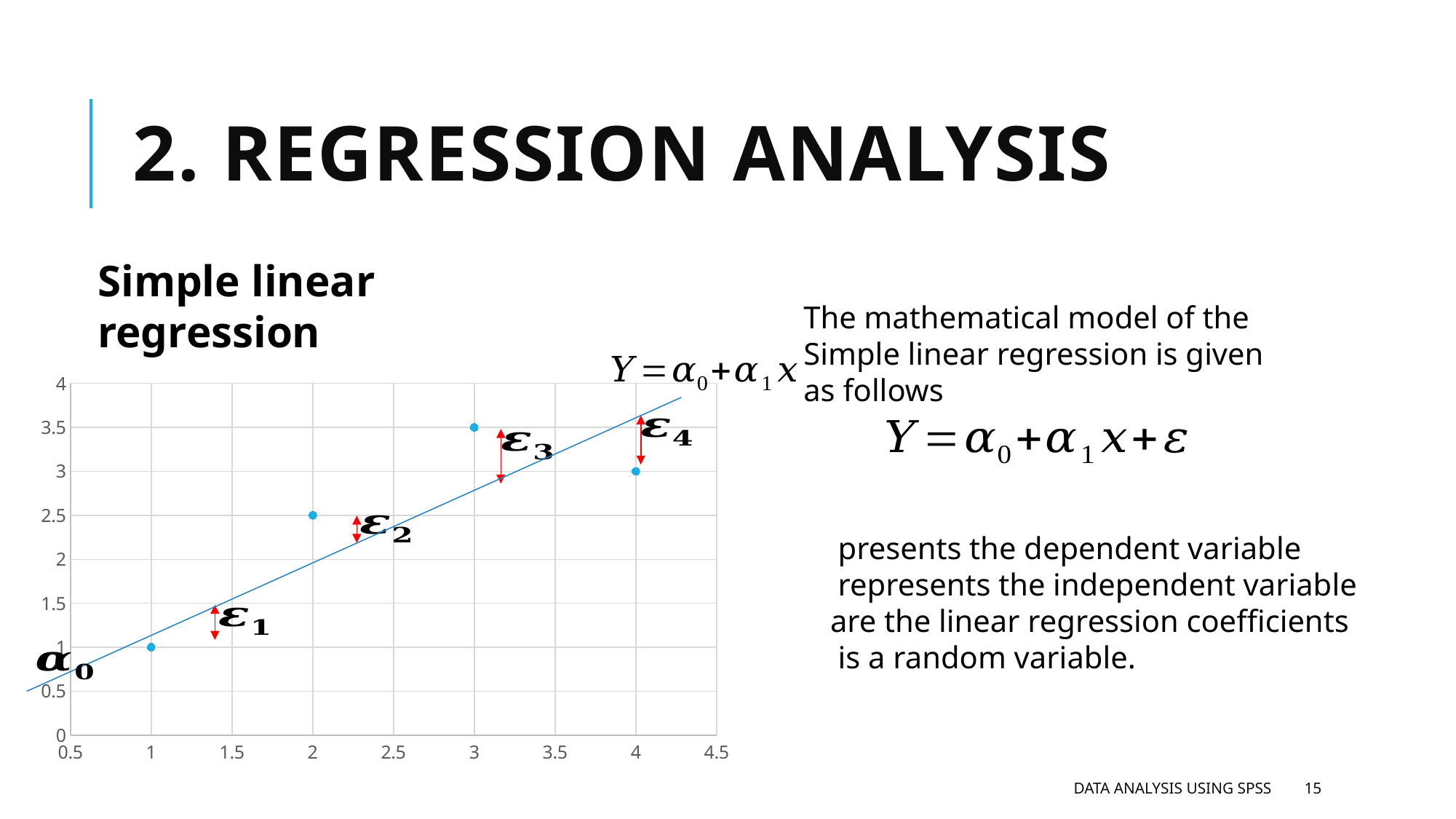
What is the difference between the y values of the points at x = 3 and x = 1? 2.5 How many data points are plotted in the scatter chart? 4 At which x value does the data point with the highest y value occur? 3 What is the label written next to the fitted line at the top right of the chart? Y = α0 + α1 x At which x value does the data point with the lowest y value occur? 1 What kind of chart is shown on the slide? scatter chart What is the y value of the data point at x = 3? 3.5 What is the maximum value shown on the y axis of the chart? 4 What is the y value of the data point at x = 4? 3 What is the y value of the data point at x = 1? 1 Which has a larger y value, the point at x = 2 or the point at x = 4? the point at x = 4 What is the y value of the data point at x = 2? 2.5